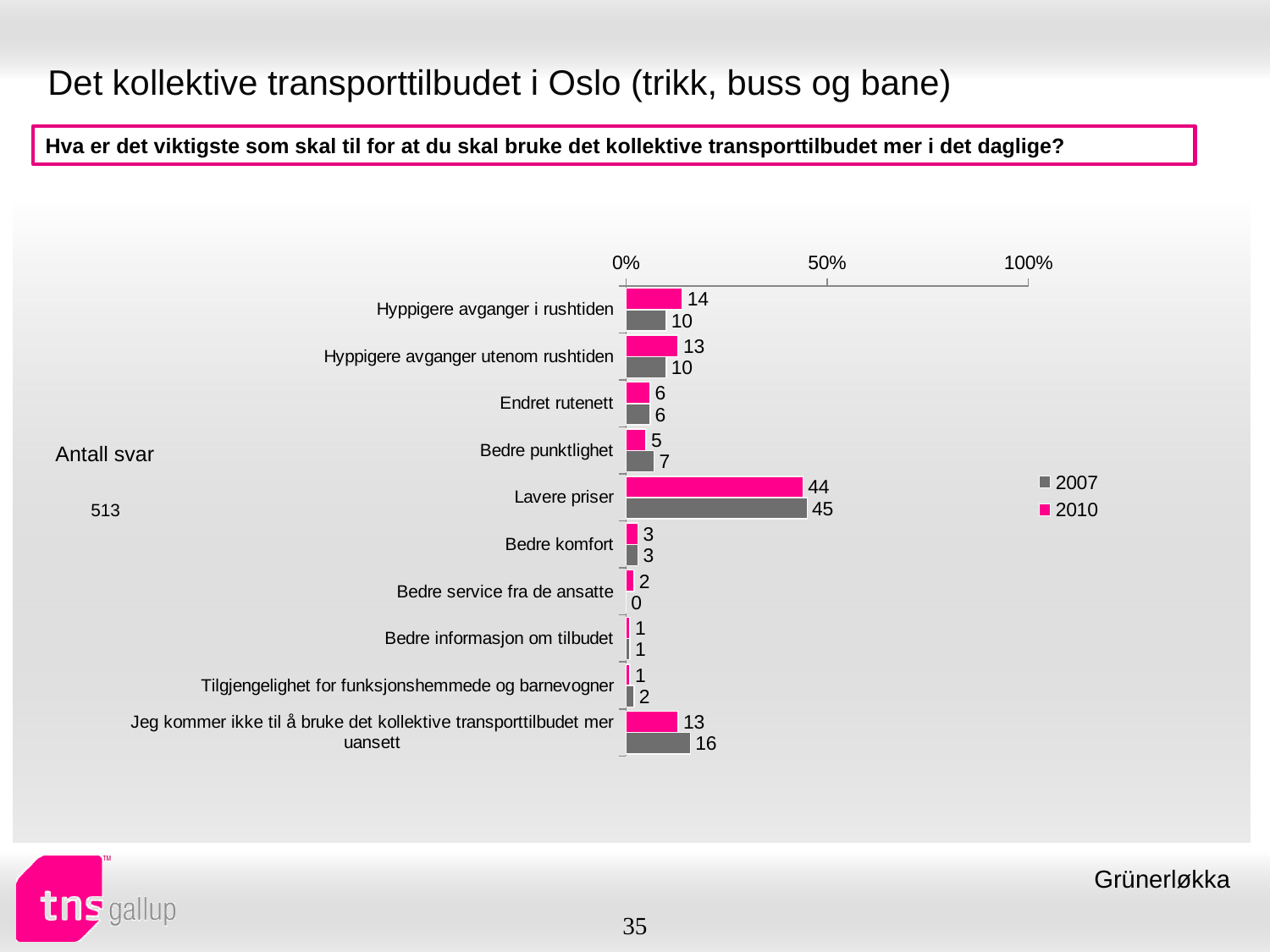
What is the 2010 value for "Bedre punktlighet"? 5 What is the 2007 value for "Hyppigere avganger i rushtiden"? 10 How many series does the legend list? 2 What is the 2010 value for "Lavere priser"? 44 Which category has the lowest 2007 value? Bedre service fra de ansatte What is the difference between the 2007 and 2010 values for "Jeg kommer ikke til å bruke det kollektive transporttilbudet mer uansett"? 3 What kind of chart is shown on the slide? bar chart How many categories are shown on the chart? 10 Which category has the highest 2010 value? Lavere priser Which is larger for "Hyppigere avganger utenom rushtiden": the 2007 value or the 2010 value? 2010 What is the 2007 value for "Jeg kommer ikke til å bruke det kollektive transporttilbudet mer uansett"? 16 Is the 2007 value for "Lavere priser" greater or less than 50%? less